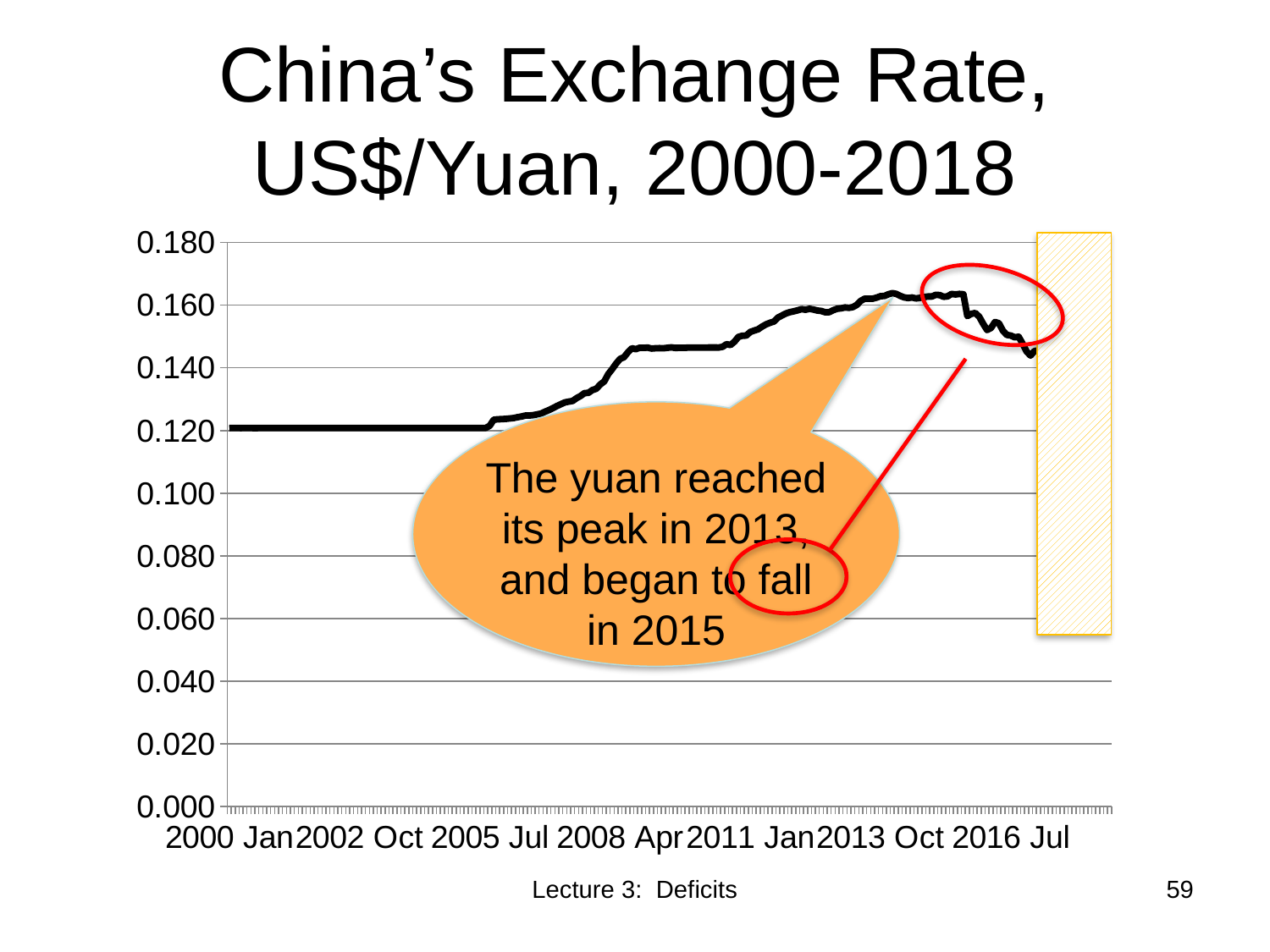
What kind of chart is shown on the slide? line chart What is the title of the chart on the slide? China's Exchange Rate, US$/Yuan, 2000-2018 Does the exchange rate rise or fall between 2005 Jul and 2013 Oct? rise How many date labels are shown on the x axis? 7 Is the exchange rate at 2000 Jan greater or less than 0.140? less Is the exchange rate at 2000 Jan greater or less than 0.100? greater Is the exchange rate at 2016 Jul greater or less than 0.160? less Which is larger, the exchange rate at 2000 Jan or at 2013 Oct? 2013 Oct According to the annotation on the chart, in which year did the yuan reach its peak? 2013 Which is larger, the exchange rate at 2000 Jan or at 2008 Apr? 2008 Apr